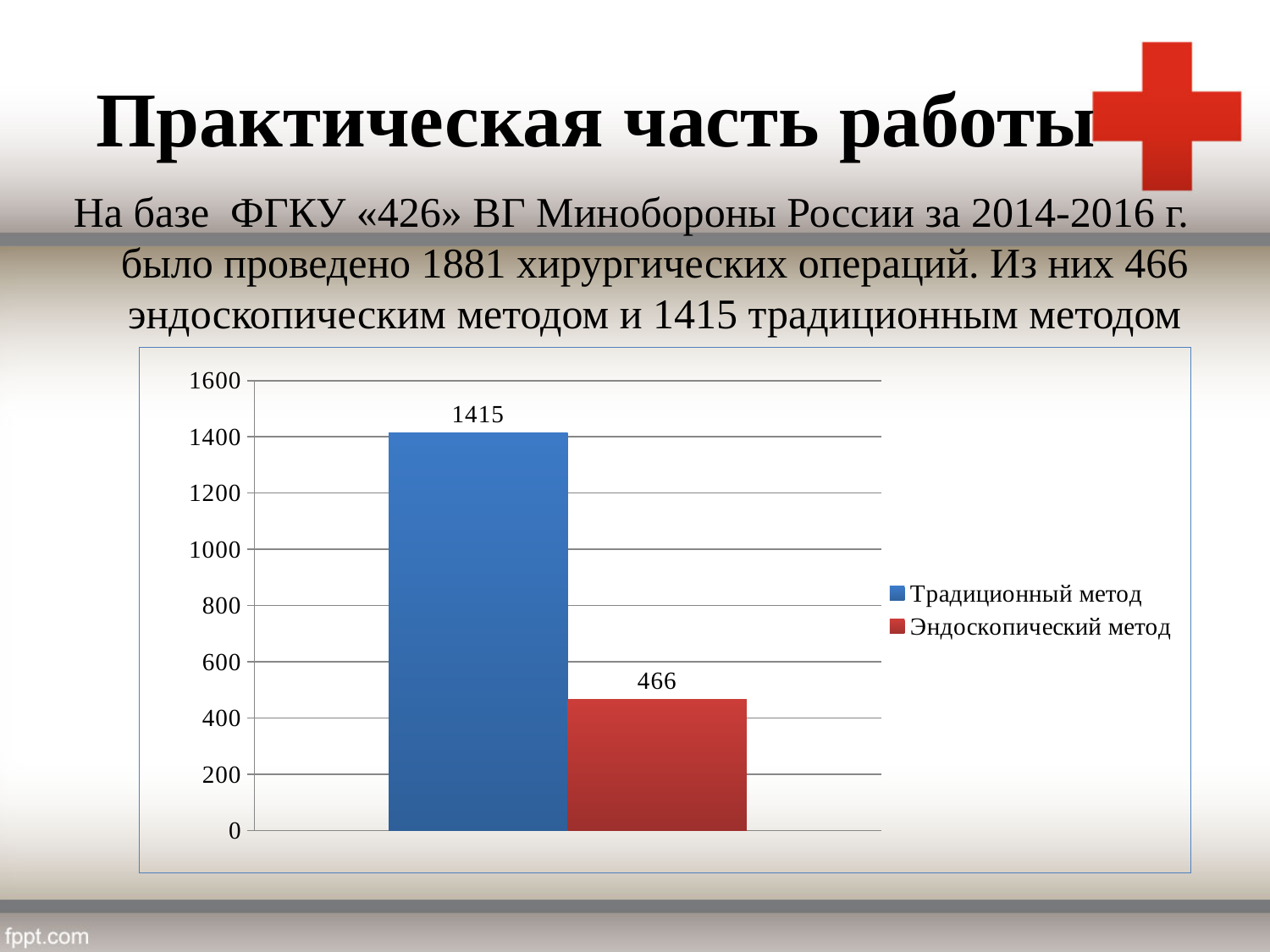
Which is larger, the value for Традиционный метод or the value for Эндоскопический метод? Традиционный метод What is the value for Традиционный метод? 1415 Which series has the lowest value? Эндоскопический метод What colour is the bar for Эндоскопический метод? red What is the value for Эндоскопический метод? 466 What is the difference between the values for Традиционный метод and Эндоскопический метод? 949 Is the value for Эндоскопический метод greater or less than 600? less Which series has the highest value? Традиционный метод What is the total of the two bars shown in the chart? 1881 What kind of chart is shown on the slide? bar chart Is the value for Традиционный метод greater or less than 1200? greater How many series does the legend list? 2